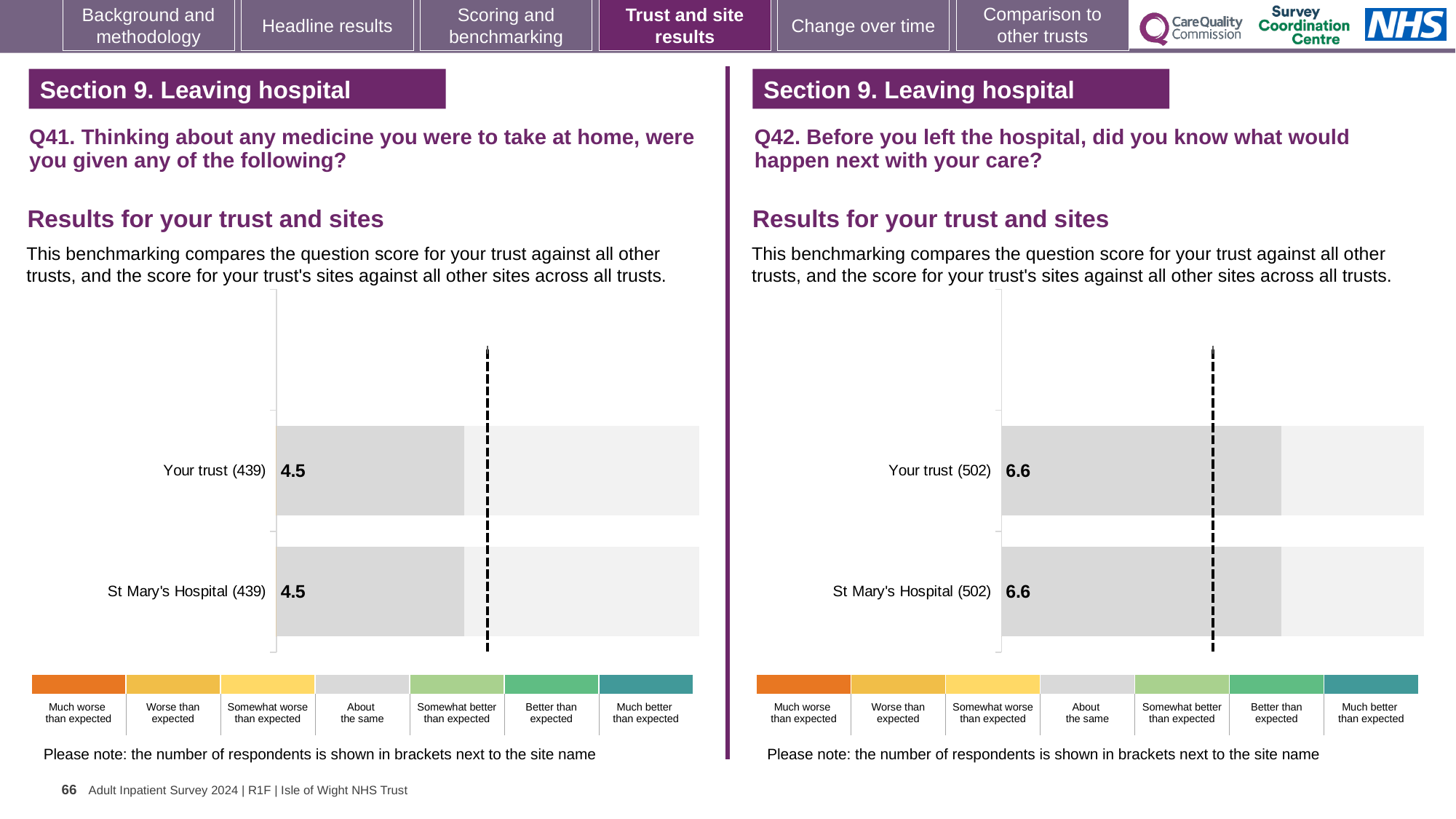
On the Q41 chart (left), how many respondents are shown in brackets next to Your trust? 439 On the Q42 chart (right), how many bars are plotted? 2 On the Q41 chart (left), what is the difference between the score for Your trust and the score for St Mary's Hospital? 0 What kind of chart is the Q41 chart on the left? Bar chart On the Q42 chart (right), what is the score for Your trust? 6.6 On the Q42 chart (right), what is the score for St Mary's Hospital? 6.6 On the Q41 chart (left), what is the score for St Mary's Hospital? 4.5 On the Q42 chart (right), how many respondents are shown in brackets next to St Mary's Hospital? 502 On the Q42 chart (right), what is the difference between the score for Your trust and the score for St Mary's Hospital? 0 Is the score for Your trust on the Q42 chart (right) larger or smaller than the score for Your trust on the Q41 chart (left)? Larger On the Q41 chart (left), what is the score for Your trust? 4.5 On the Q41 chart (left), how many bars are plotted? 2